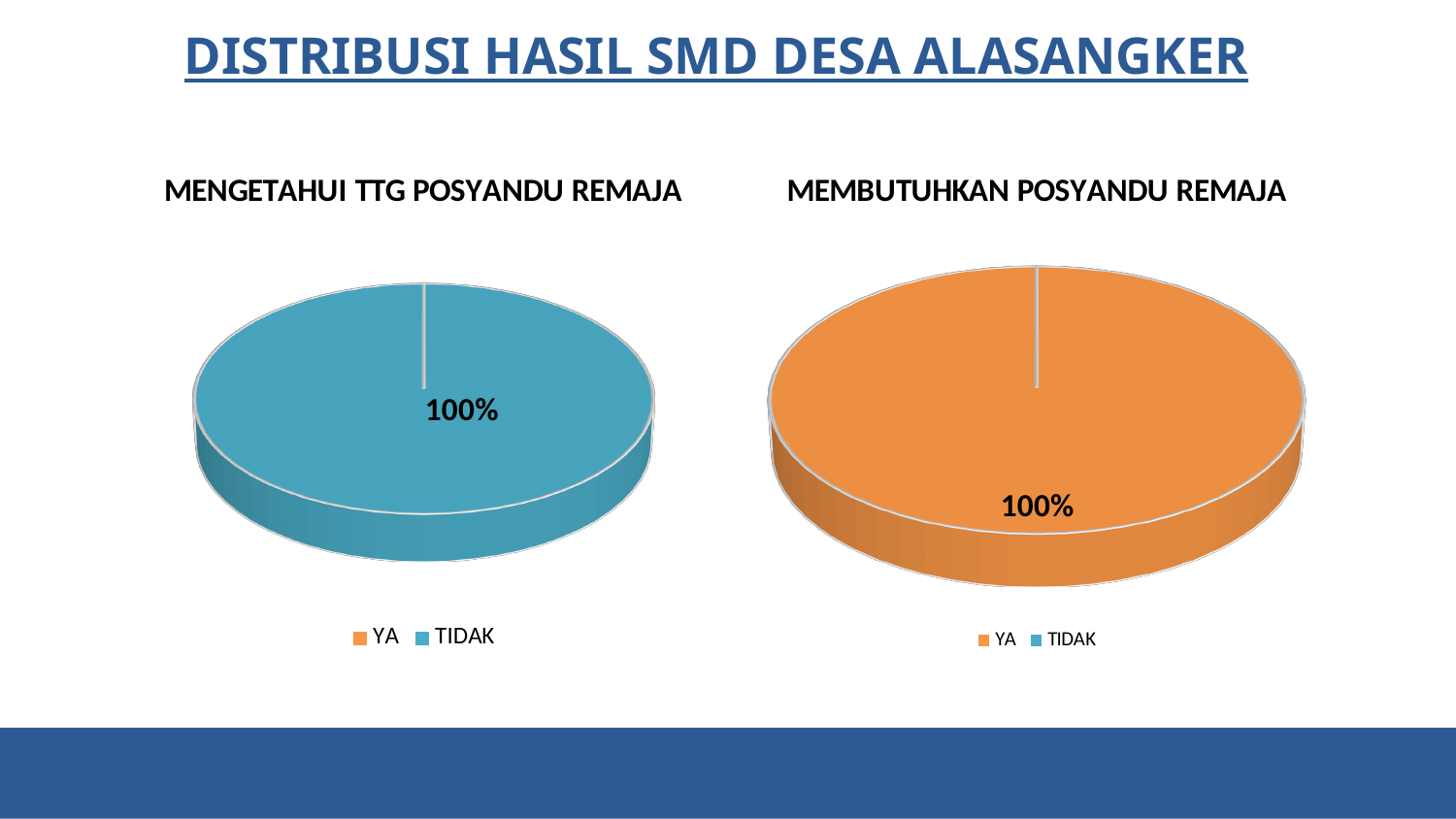
What kind of chart is the 'MENGETAHUI TTG POSYANDU REMAJA' chart? Pie chart In the 'MEMBUTUHKAN POSYANDU REMAJA' chart, which category makes up the whole pie? YA In the 'MENGETAHUI TTG POSYANDU REMAJA' chart, which category makes up the whole pie? TIDAK What kind of chart is the 'MEMBUTUHKAN POSYANDU REMAJA' chart? Pie chart In the 'MEMBUTUHKAN POSYANDU REMAJA' chart, which is larger, YA or TIDAK? YA In the 'MENGETAHUI TTG POSYANDU REMAJA' chart, which is larger, YA or TIDAK? TIDAK In the 'MEMBUTUHKAN POSYANDU REMAJA' chart, what share of the pie does YA have? 100% How many entries does the legend of the 'MEMBUTUHKAN POSYANDU REMAJA' chart list? 2 What colour represents YA in the legends of the charts? Orange What is the title of the chart on the right of the slide? MEMBUTUHKAN POSYANDU REMAJA In the 'MENGETAHUI TTG POSYANDU REMAJA' chart, what share of the pie does TIDAK have? 100% How many entries does the legend of the 'MENGETAHUI TTG POSYANDU REMAJA' chart list? 2